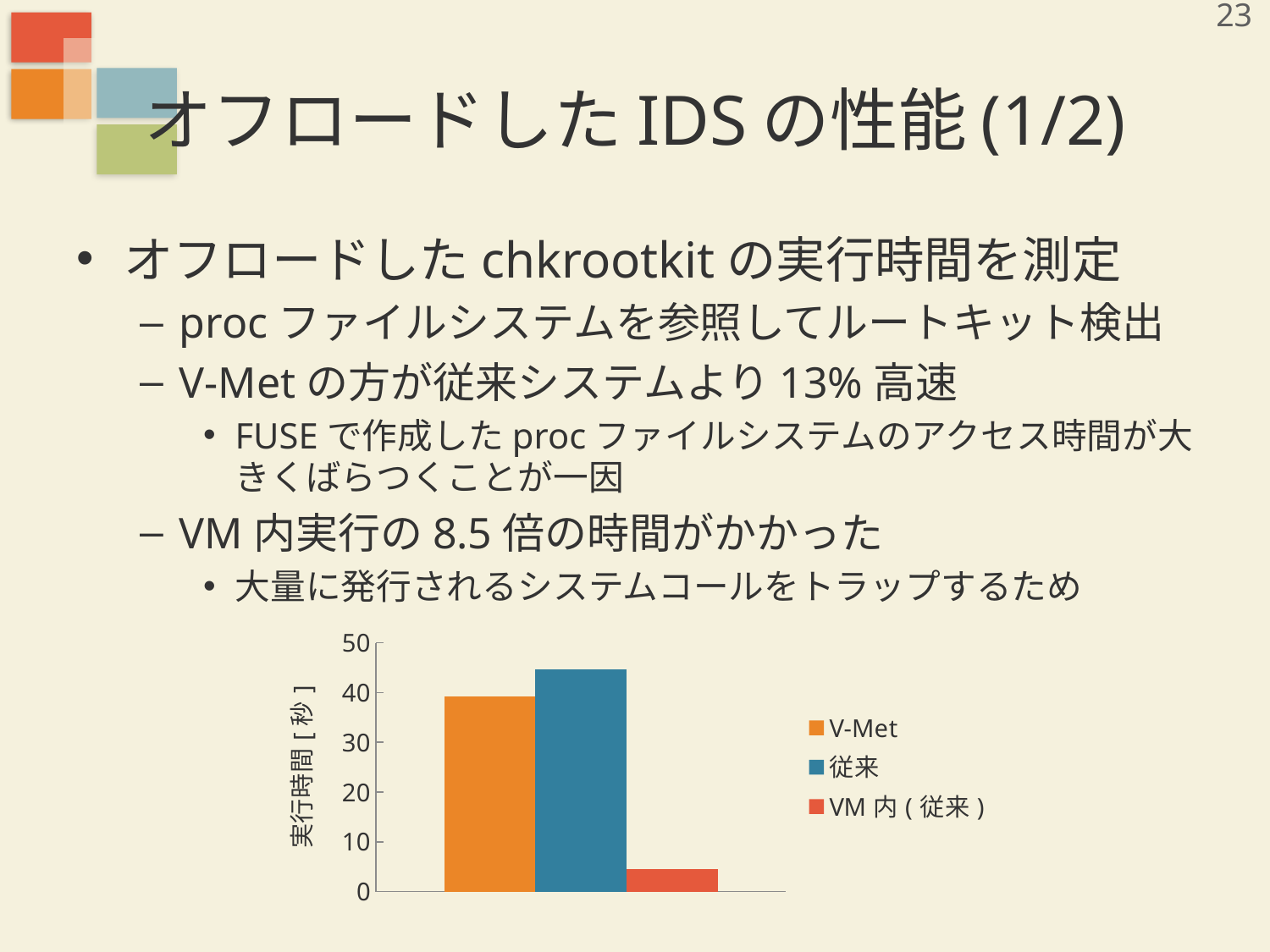
Which series has the highest execution time in the chart? 従来 How many series does the chart's legend list? 3 Which is larger in the chart, the value for V-Met or the value for VM 内 ( 従来 )? V-Met Is the value for VM 内 ( 従来 ) greater or less than 10? less Which series has the lowest execution time in the chart? VM 内 ( 従来 ) What kind of chart is shown on the slide? bar chart Which is larger in the chart, the value for V-Met or the value for 従来? 従来 Is the value for 従来 greater or less than 40? greater Is the value for V-Met greater or less than 30? greater How many bars are plotted in the chart? 3 What colour is the V-Met series in the chart? orange What is the label of the chart's vertical axis? 実行時間 [ 秒 ]